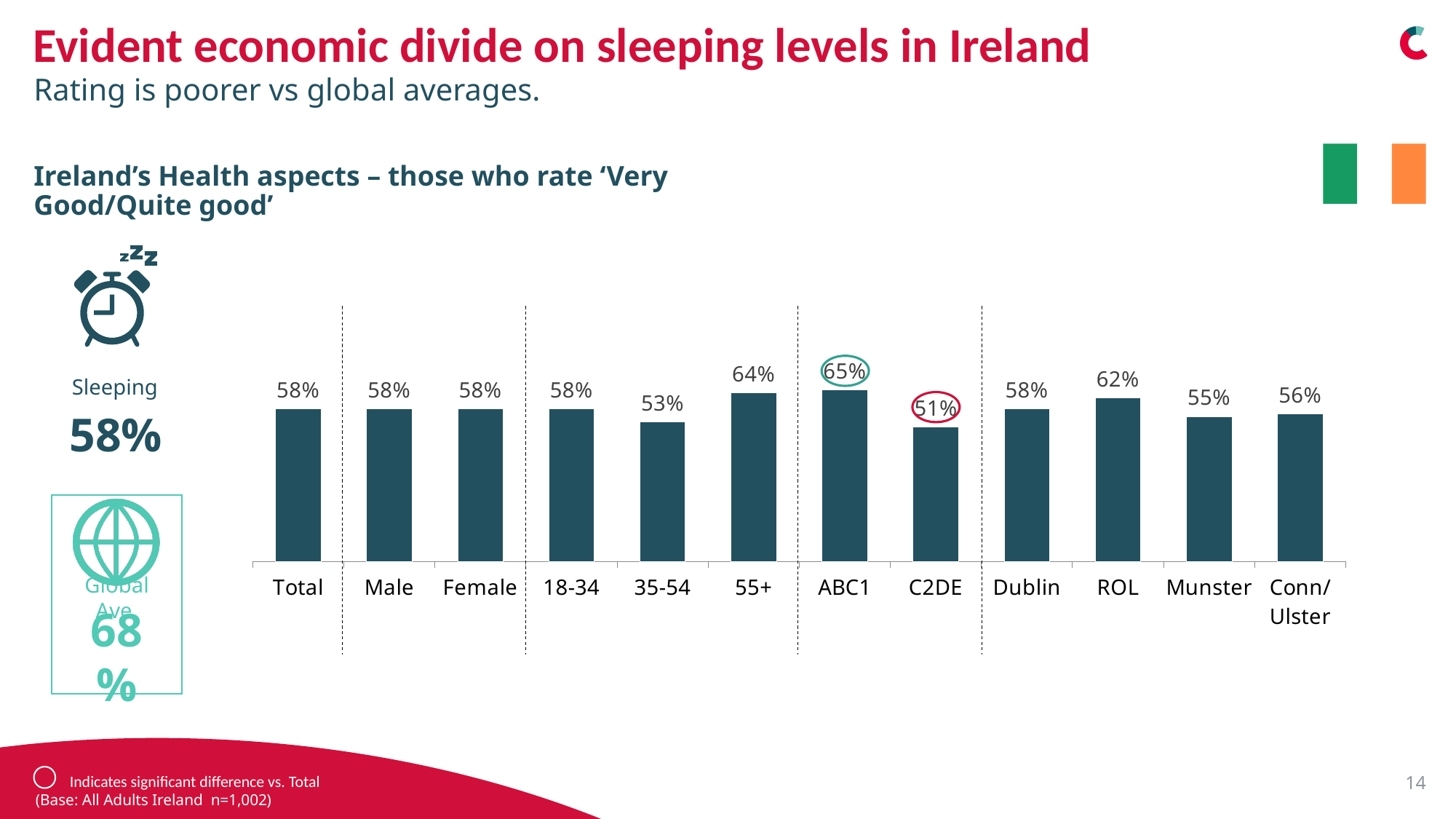
What is the value for ABC1? 65% What kind of chart is shown? Bar chart What is the value for C2DE? 51% How many categories are shown on the x axis? 12 Which has a larger value, 55+ or 35-54? 55+ What is the value for the 35-54 age group? 53% What is the difference between the values for ABC1 and C2DE? 14 percentage points Which two bars have their data labels circled to indicate a significant difference vs. Total? ABC1 and C2DE Which category has the lowest value? C2DE Which category has the highest value? ABC1